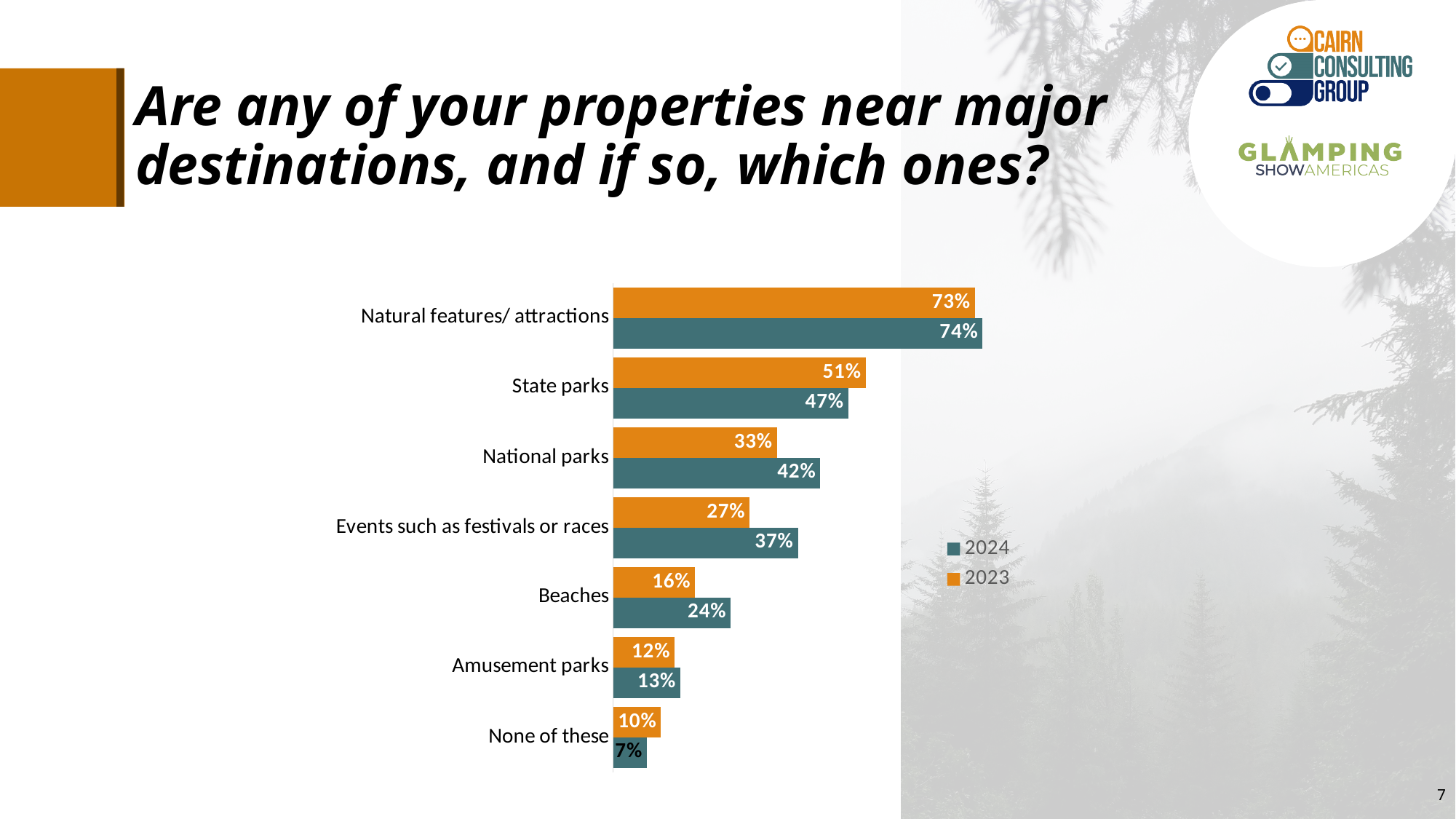
Which colour represents the 2023 series? Orange What kind of chart is shown on the slide? Bar chart Which category has the lowest 2024 value? None of these Which is larger for National parks, the 2023 value or the 2024 value? 2024 What is the 2024 value for National parks? 42% What is the 2024 value for Events such as festivals or races? 37% What is the 2023 value for Beaches? 16% What is the difference between the 2023 and 2024 values for State parks? 4% How many categories are shown on the chart? 7 What is the difference between the 2024 and 2023 values for Events such as festivals or races? 10% Which category has the highest 2024 value? Natural features/ attractions How many series does the legend list? 2